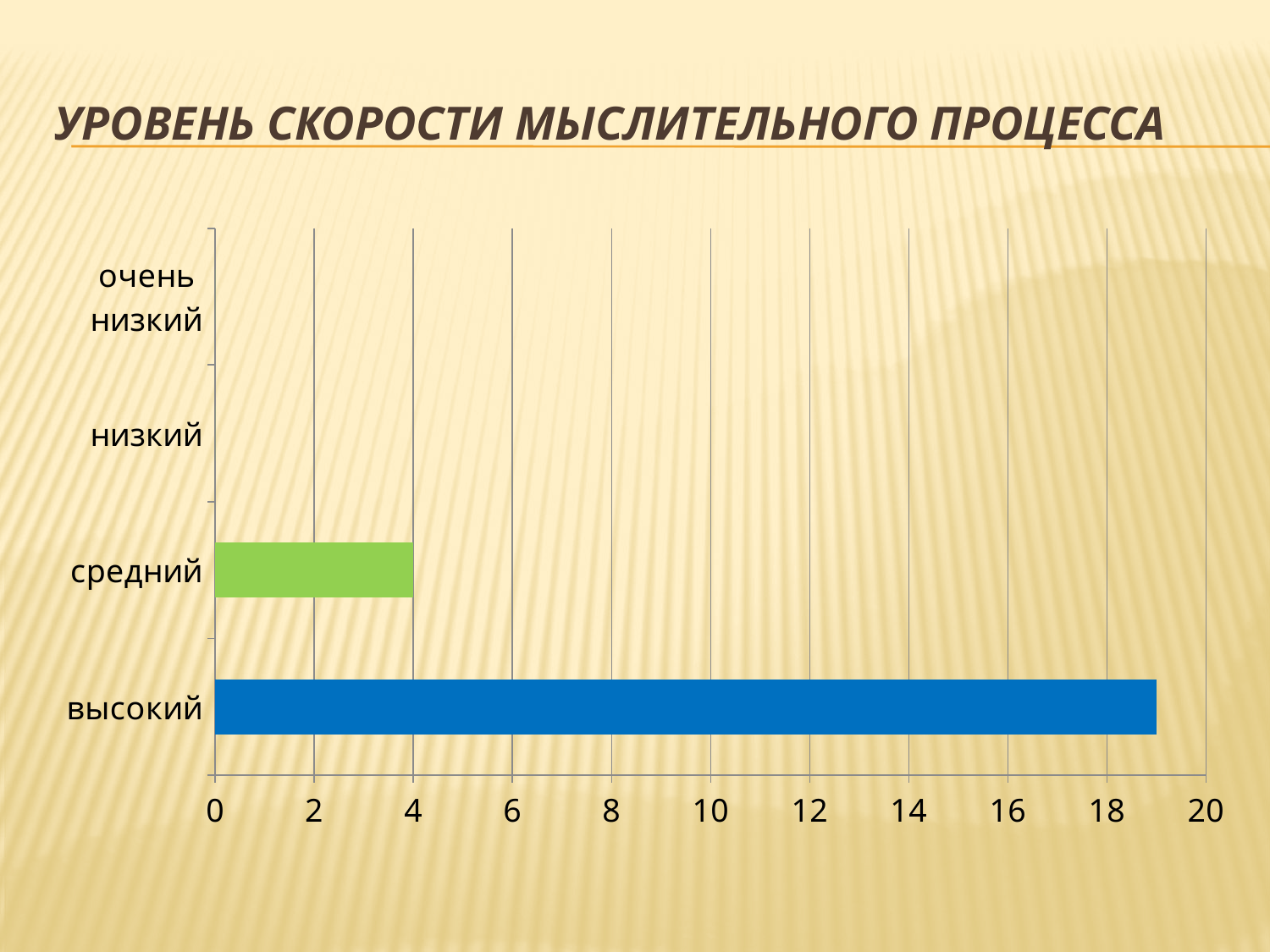
What is the value for the category 'средний'? 4 How many categories are shown on the vertical axis of the chart? 4 Is the value for 'высокий' greater or less than 18? greater What kind of chart is shown on the slide? bar chart What is the title of the slide containing the chart? УРОВЕНЬ СКОРОСТИ МЫСЛИТЕЛЬНОГО ПРОЦЕССА Which category has the highest value in the chart? высокий What colour is the bar for the category 'высокий'? blue Which category has the larger value, 'высокий' or 'средний'? высокий How many categories in the chart have no visible bar? 2 Is the value for 'средний' greater or less than 10? less Is the value for 'высокий' greater or less than 20? less